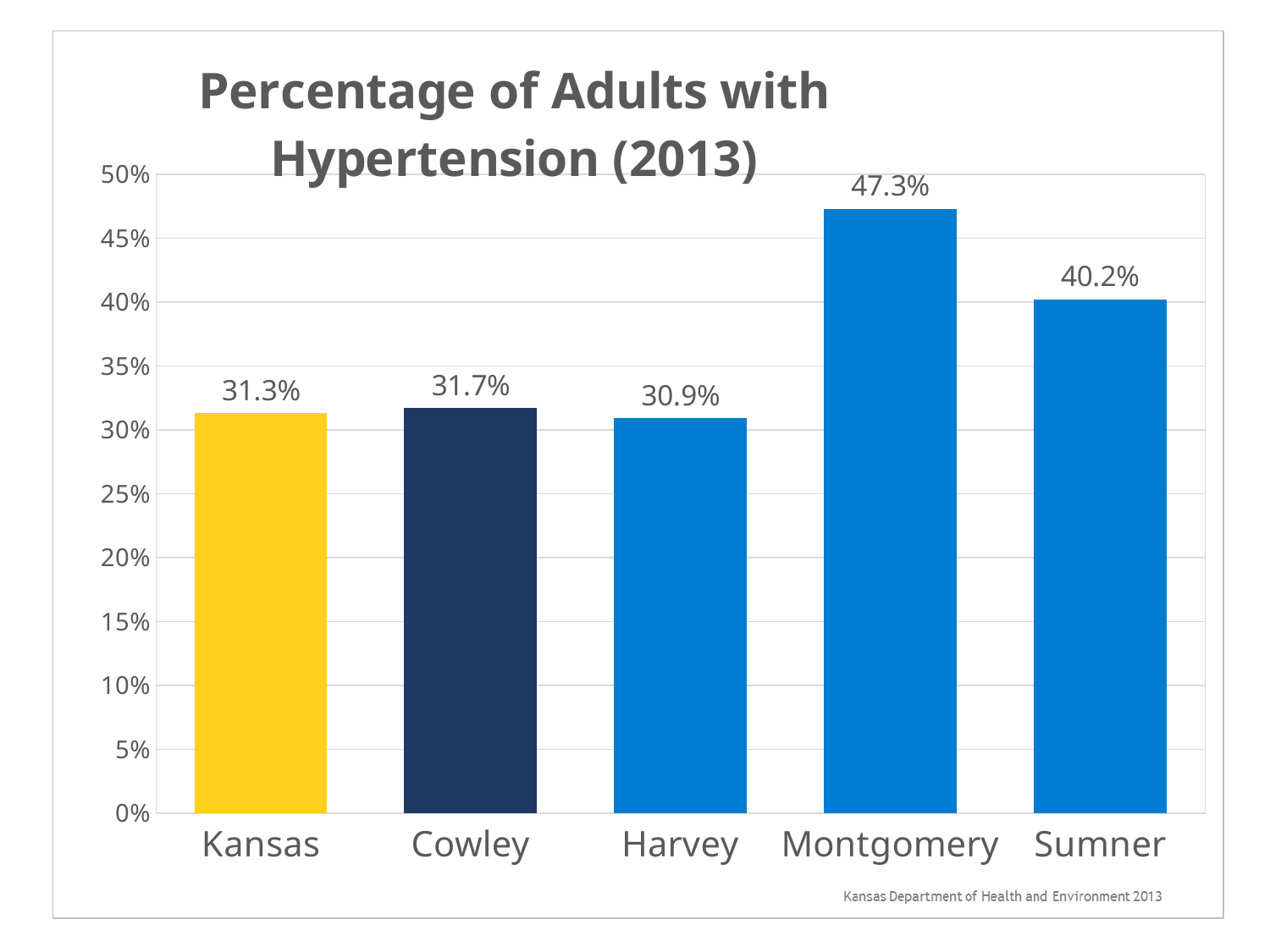
What is the title of the chart? Percentage of Adults with Hypertension (2013) What kind of chart is shown on the slide? Bar chart Which category has the lowest percentage of adults with hypertension? Harvey Which has a higher percentage of adults with hypertension, Sumner or Cowley? Sumner How many categories are shown on the chart? 5 What is the percentage of adults with hypertension in Harvey? 30.9% What is the percentage of adults with hypertension in Kansas? 31.3% What is the difference between the percentages for Cowley and Kansas? 0.4% What is the difference between the percentages for Montgomery and Sumner? 7.1% What is the percentage of adults with hypertension in Montgomery? 47.3% Which category has the highest percentage of adults with hypertension? Montgomery Is the value for Sumner greater or less than 35%? greater